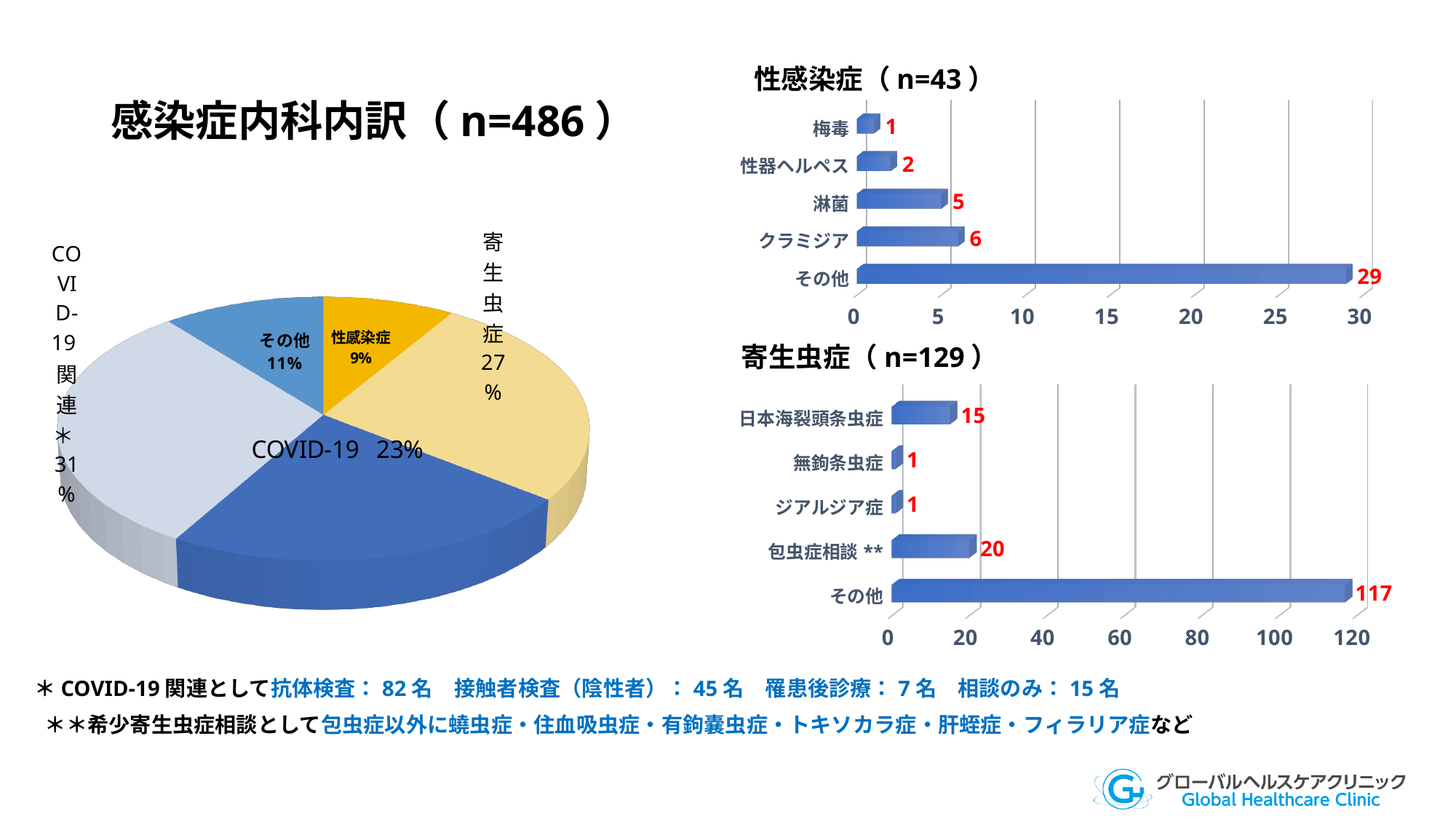
In the 感染症内科内訳 pie chart, what share does COVID-19 have? 23% How many categories are shown in the 性感染症 chart? 5 In the 性感染症 chart, what is the difference between 淋菌 and 性器ヘルペス? 3 In the 寄生虫症 chart, which is larger, 日本海裂頭条虫症 or 包虫症相談 **? 包虫症相談 ** In the 寄生虫症 chart, what is the value for 包虫症相談 **? 20 In the 感染症内科内訳 pie chart, which slice is the largest? COVID-19関連＊ In the 感染症内科内訳 pie chart, which slice is the smallest? 性感染症 In the 感染症内科内訳 pie chart, what share does 寄生虫症 have? 27% In the 性感染症 chart, which category has the highest value? その他 What kind of chart is the 寄生虫症 chart? bar chart In the 性感染症 chart, what is the value for クラミジア? 6 What kind of chart is the 感染症内科内訳 chart? pie chart